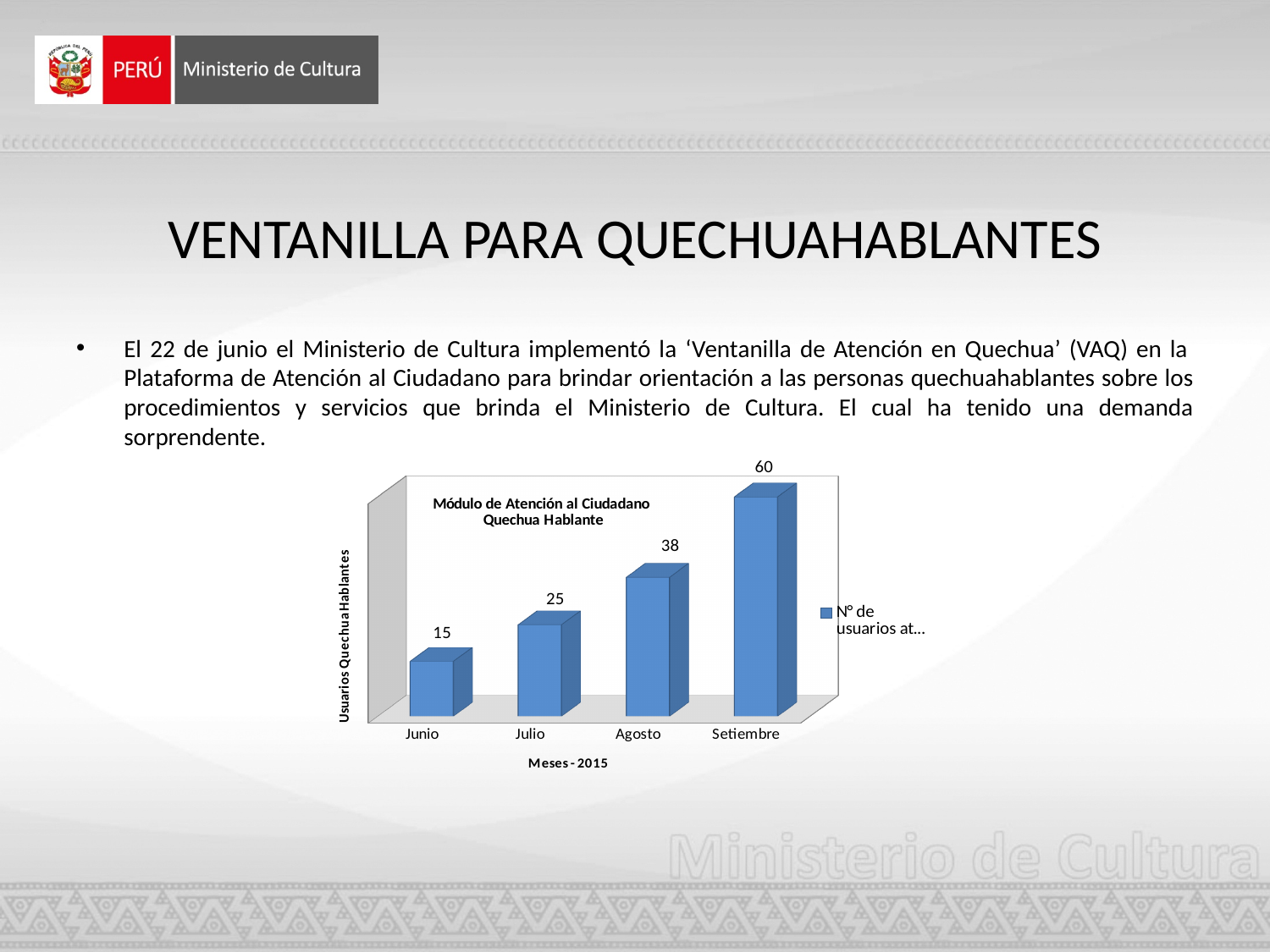
What is the title of the chart? Módulo de Atención al Ciudadano Quechua Hablante What kind of chart is shown? bar chart What is the difference between the values for Julio and Junio? 10 Which month has the highest value? Setiembre Which is larger, the value for Julio or the value for Agosto? Agosto Which month has the lowest value? Junio How many months are shown on the x axis? 4 What is the value for Agosto? 38 What is the value for Junio? 15 What is the difference between the values for Setiembre and Agosto? 22 What is the value for Setiembre? 60 Do the values rise or fall from Junio to Setiembre? rise